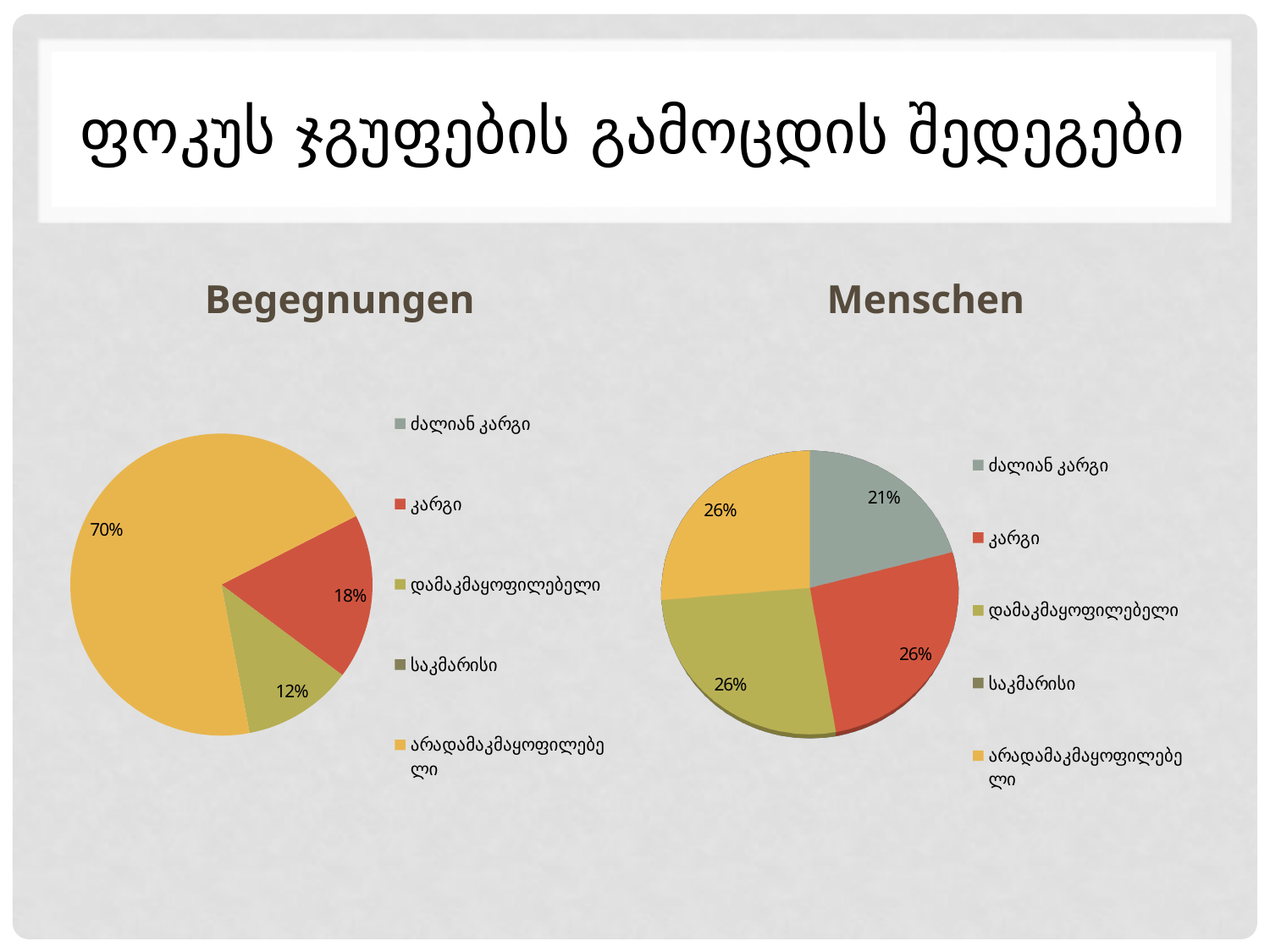
In the Menschen chart, what percentage is shown for ძალიან კარგი? 21% In the Begegnungen chart, what percentage is shown for კარგი? 18% In the Begegnungen chart, which category has the smallest slice? დამაკმაყოფილებელი In the Begegnungen chart, what percentage is shown for დამაკმაყოფილებელი? 12% In the Begegnungen chart, what is the difference between the არადამაკმაყოფილებელი and კარგი shares? 52% In the Begegnungen chart, which category has the largest slice? არადამაკმაყოფილებელი In the Menschen chart, what percentage is shown for კარგი? 26% In the Menschen chart, which category has the smallest slice? ძალიან კარგი How many slices with data labels does the Menschen chart have? 4 In the Begegnungen chart, what share does the არადამაკმაყოფილებელი slice have? 70% Which is larger: the კარგი share in the Begegnungen chart or the კარგი share in the Menschen chart? Menschen What type of chart is the Begegnungen chart? Pie chart